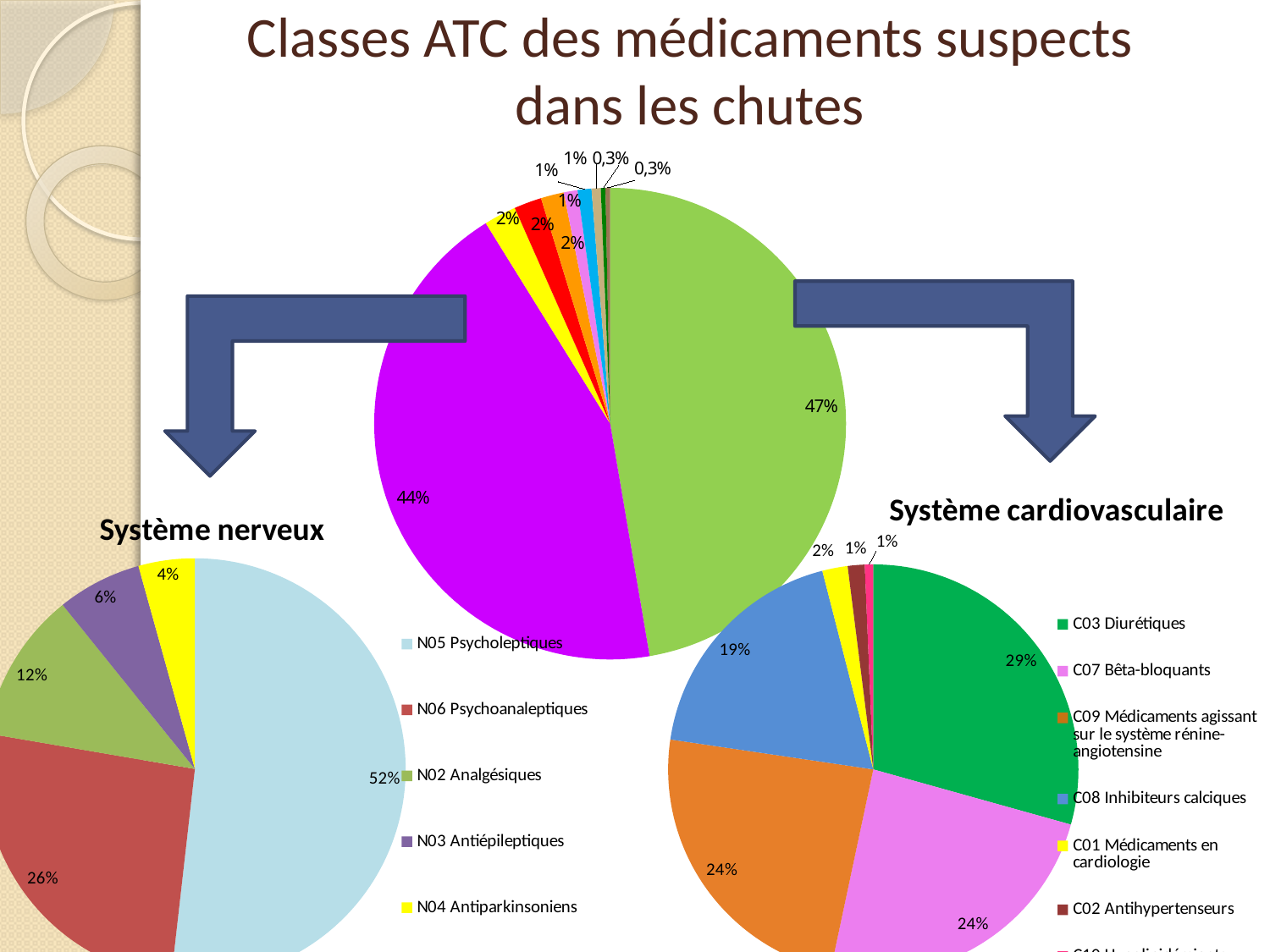
How many categories does the Système nerveux pie chart show? 5 In the Système cardiovasculaire pie chart, what share does C03 Diurétiques have? 29% In the Système cardiovasculaire pie chart, what share does C08 Inhibiteurs calciques have? 19% In the Système nerveux pie chart, what share does N05 Psycholeptiques have? 52% In the Système nerveux pie chart, which category has the smallest share? N04 Antiparkinsoniens In the Système cardiovasculaire pie chart, which category has the largest share? C03 Diurétiques In the Système nerveux pie chart, what is the difference in percentage points between N02 Analgésiques and N03 Antiépileptiques? 6 percentage points In the Système cardiovasculaire pie chart, which is larger: C07 Bêta-bloquants or C08 Inhibiteurs calciques? C07 Bêta-bloquants In the large central pie chart, what is the share of the largest slice? 47% In the large central pie chart, what is the difference in percentage points between the two largest slices? 3 percentage points What kind of chart is used for the Système cardiovasculaire data? Pie chart